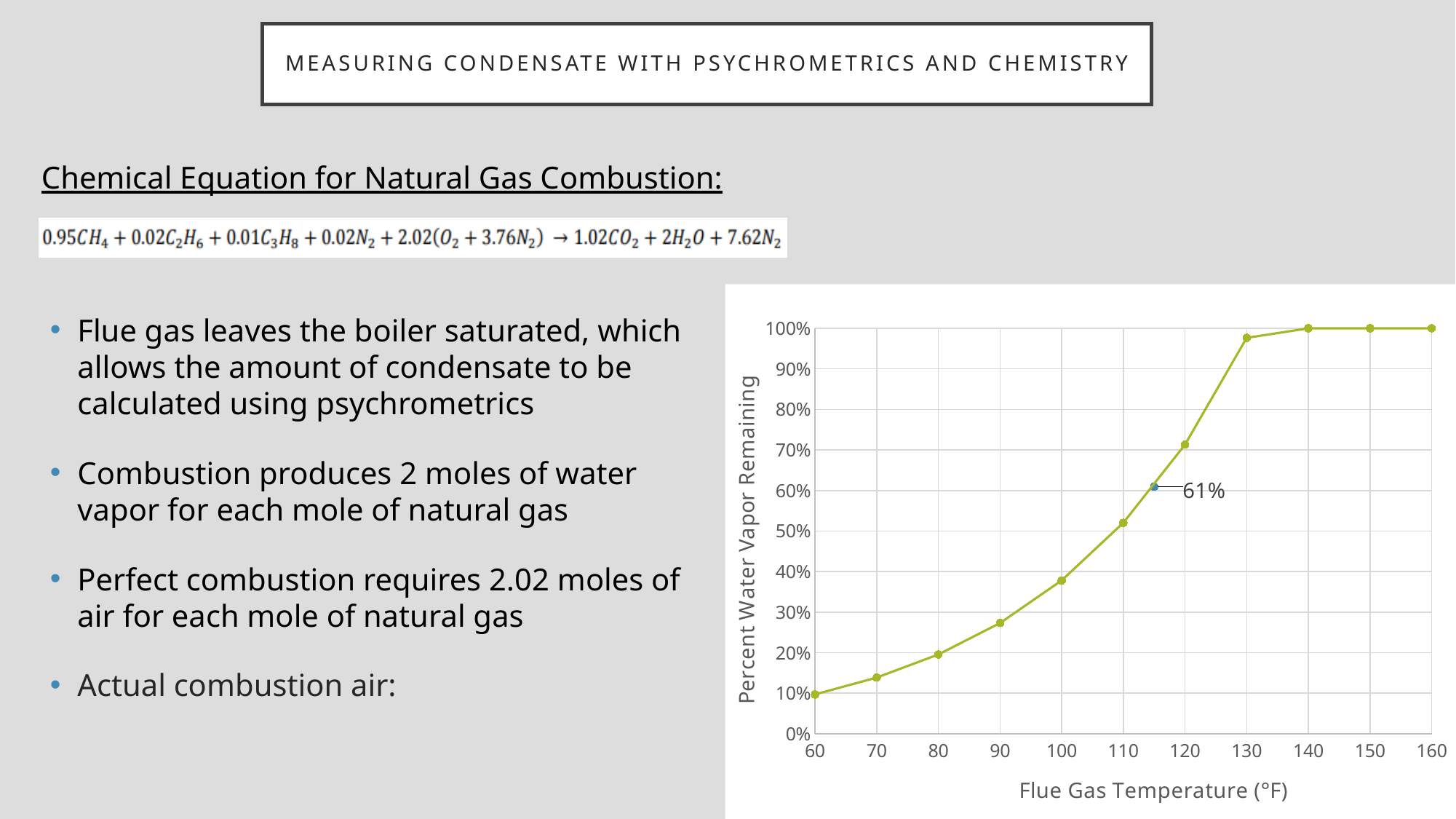
What is the percent water vapor remaining at a flue gas temperature of 140°F? 100% What is the percent water vapor remaining at a flue gas temperature of 115°F, as labeled on the chart? 61% Is the percent water vapor remaining at 120°F greater or less than 70%? greater Does the percent water vapor remaining rise or fall as flue gas temperature increases from 60°F to 140°F? rise Is the percent water vapor remaining at 100°F greater or less than 40%? less What is the label of the x axis of the chart? Flue Gas Temperature (°F) Is the percent water vapor remaining at 130°F greater or less than 90%? greater What is the percent water vapor remaining at a flue gas temperature of 160°F? 100% Which has a higher percent water vapor remaining: 100°F or 120°F? 120°F What kind of chart is shown on the slide? line chart At which flue gas temperature is the percent water vapor remaining lowest? 60